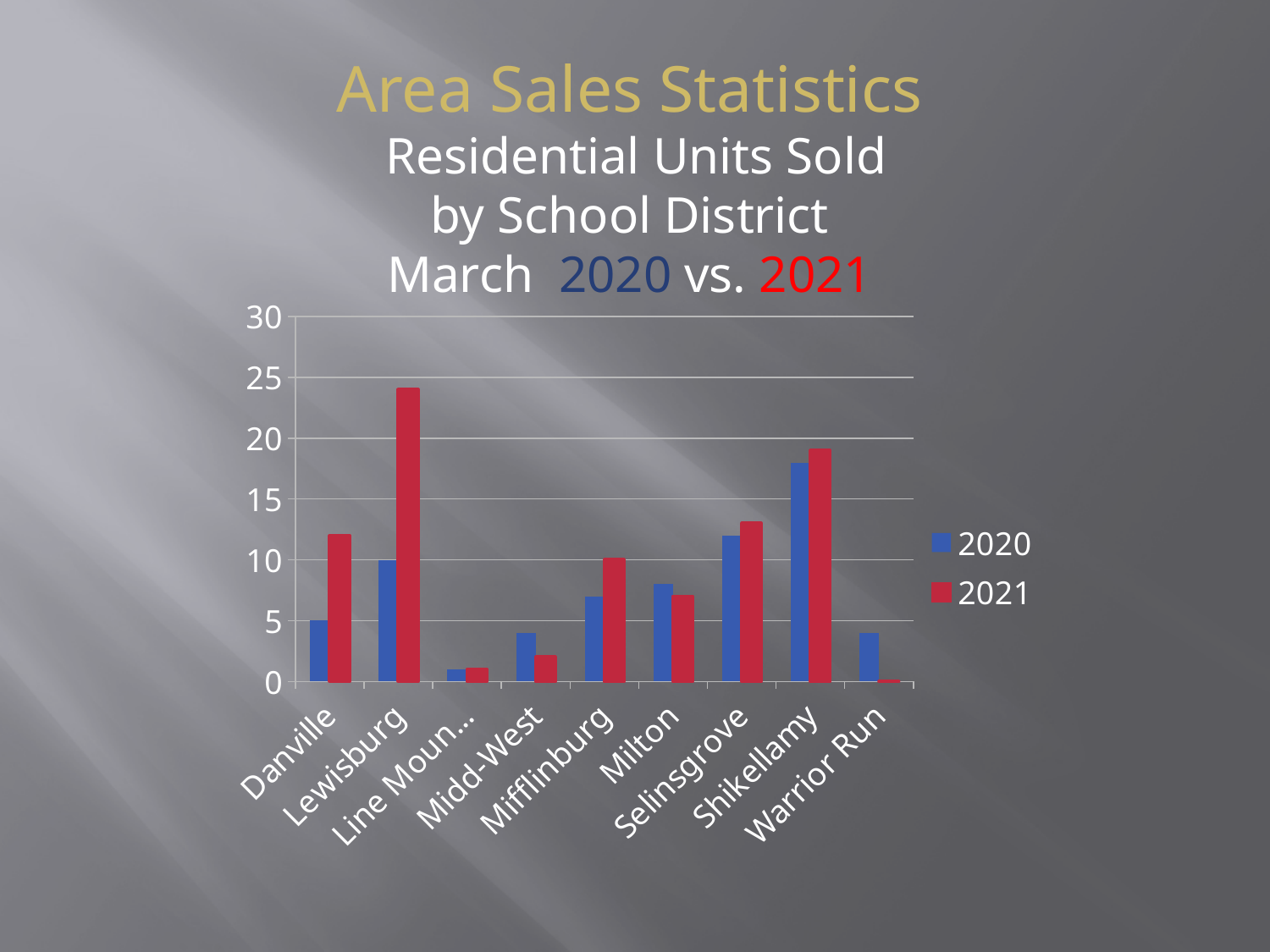
What is the 2020 value for Lewisburg? 10 Which school district has the highest value for 2020? Shikellamy How many school districts are shown on the x axis? 9 Which school district has the lowest value for 2021? Warrior Run For Midd-West, which year has the larger value, 2020 or 2021? 2020 Is the 2021 value for Lewisburg greater or less than 20? greater For Danville, which year has the larger value, 2020 or 2021? 2021 Is the 2020 value for Shikellamy greater or less than 15? greater Which school district has the highest value for 2021? Lewisburg How many series does the legend list? 2 Which colour represents the 2021 series in the legend? red What kind of chart is shown on the slide? bar chart